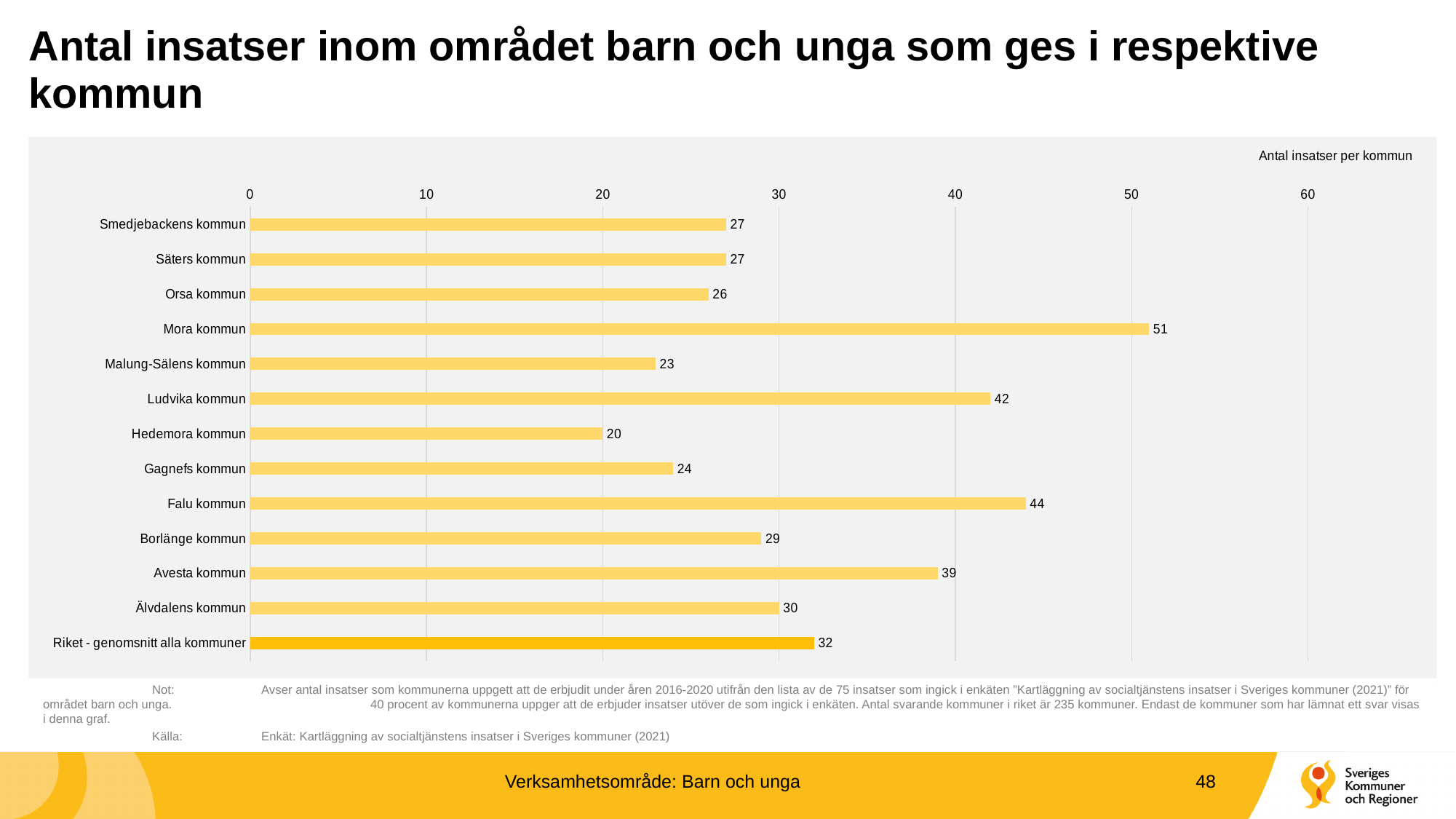
What is the value for Mora kommun? 51 What is the difference between the value for Mora kommun and the value for Riket - genomsnitt alla kommuner? 19 Which is larger, the value for Avesta kommun or the value for Borlänge kommun? Avesta kommun Which category has the highest value? Mora kommun Is the value for Älvdalens kommun greater or less than 20? greater Which category has the lowest value? Hedemora kommun What kind of chart is shown on the slide? Bar chart How many categories are shown in the chart? 13 What is the value for Riket - genomsnitt alla kommuner? 32 What is the label shown at the top right of the chart area? Antal insatser per kommun What is the difference between the values for Falu kommun and Ludvika kommun? 2 What is the value for Hedemora kommun? 20